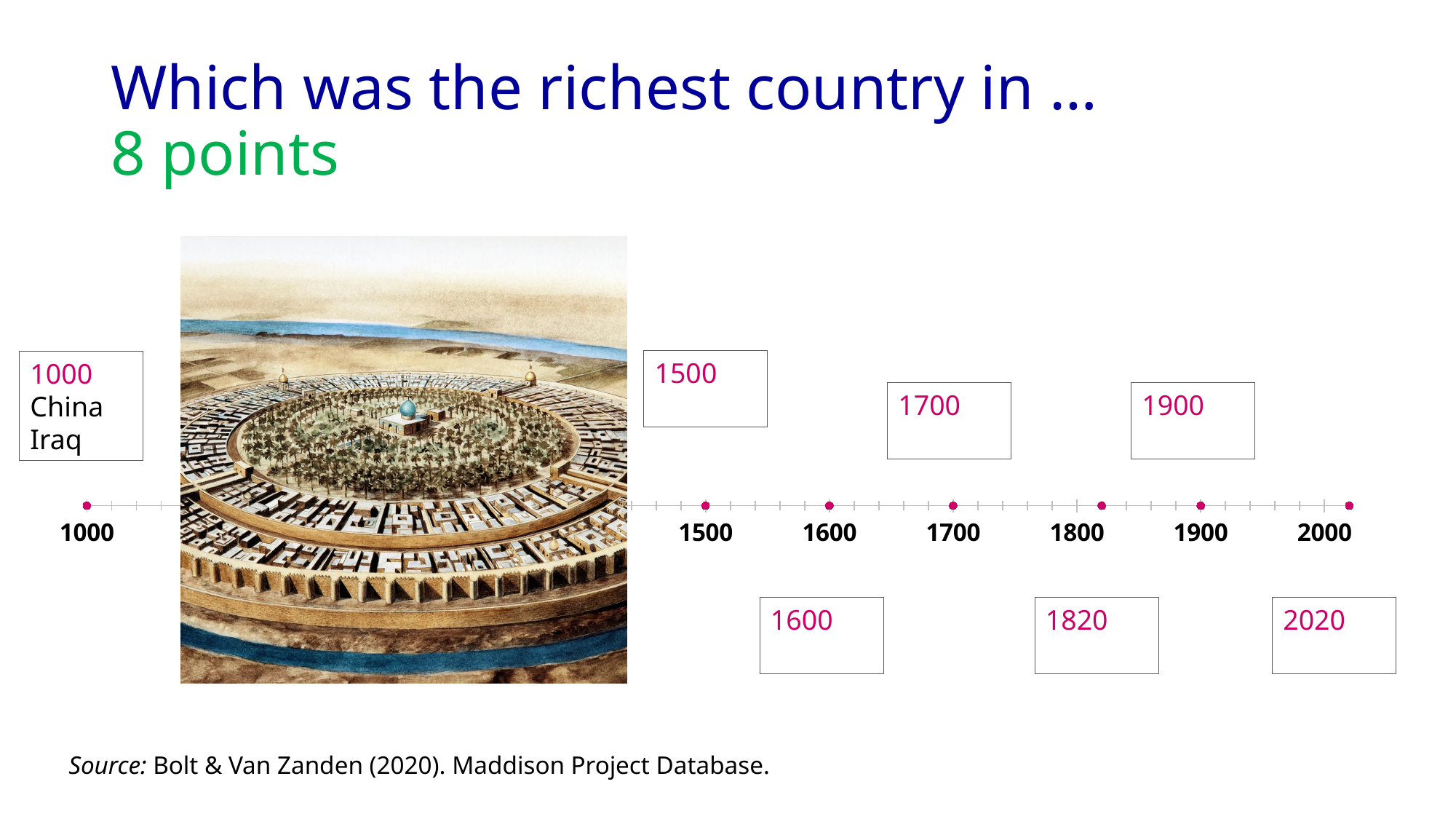
What are the axis tick labels shown along the timeline? 1000, 1500, 1600, 1700, 1800, 1900, 2000 How many labelled year boxes are shown along the timeline? 7 Which is later on the timeline, the point labelled 1600 or the point labelled 1500? 1600 What source is cited for the timeline? Bolt & Van Zanden (2020). Maddison Project Database. Which labelled year on the timeline falls between 1700 and 1900? 1820 Is the point labelled 1820 positioned before or after the 1800 axis tick? after What is the earliest year marked on the timeline? 1000 What kind of chart is shown on the slide? A timeline What is the latest year labelled in a box on the timeline? 2020 Which countries are listed in the box for the year 1000 on the timeline? China and Iraq Which year box on the timeline is the only one that names countries? 1000